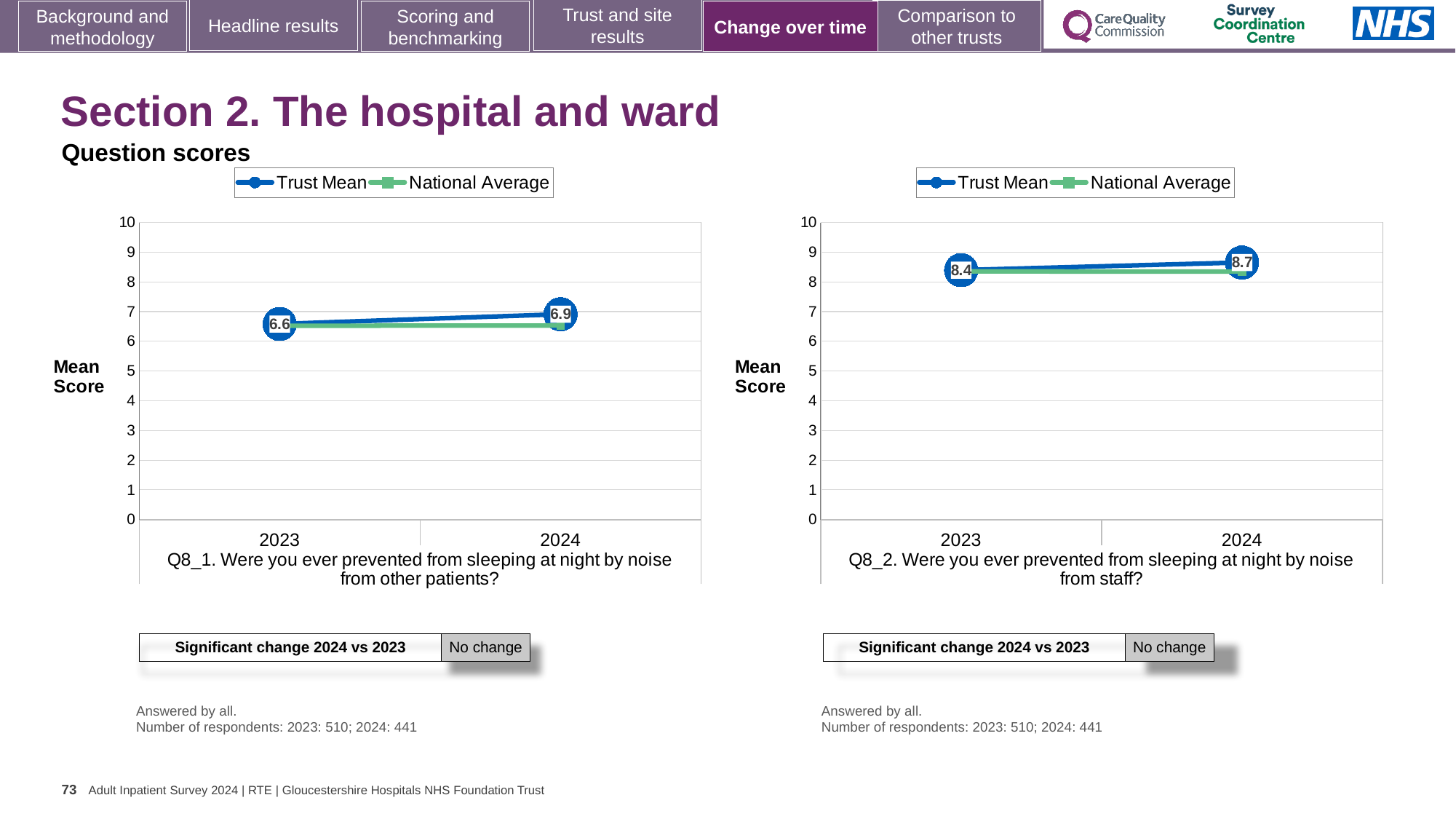
In the left chart (Q8_1), does the Trust Mean rise or fall from 2023 to 2024? rise How many series does the legend of the right chart (Q8_2) list? 2 In the right chart (Q8_2), is the National Average for 2023 greater or less than 8? greater In the right chart (Q8_2), which year has the higher Trust Mean? 2024 In the right chart (Q8_2), what is the Trust Mean for 2023? 8.4 In the right chart (Q8_2), what is the Trust Mean for 2024? 8.7 In the left chart (Q8_1), is the National Average for 2024 greater or less than 7? less What kind of chart is the left chart (Q8_1)? line chart In the left chart (Q8_1), by how much did the Trust Mean change from 2023 to 2024? 0.3 In the left chart (Q8_1), what is the Trust Mean for 2024? 6.9 In the right chart (Q8_2), what is the difference between the Trust Mean in 2024 and 2023? 0.3 In the left chart (Q8_1), what is the Trust Mean for 2023? 6.6